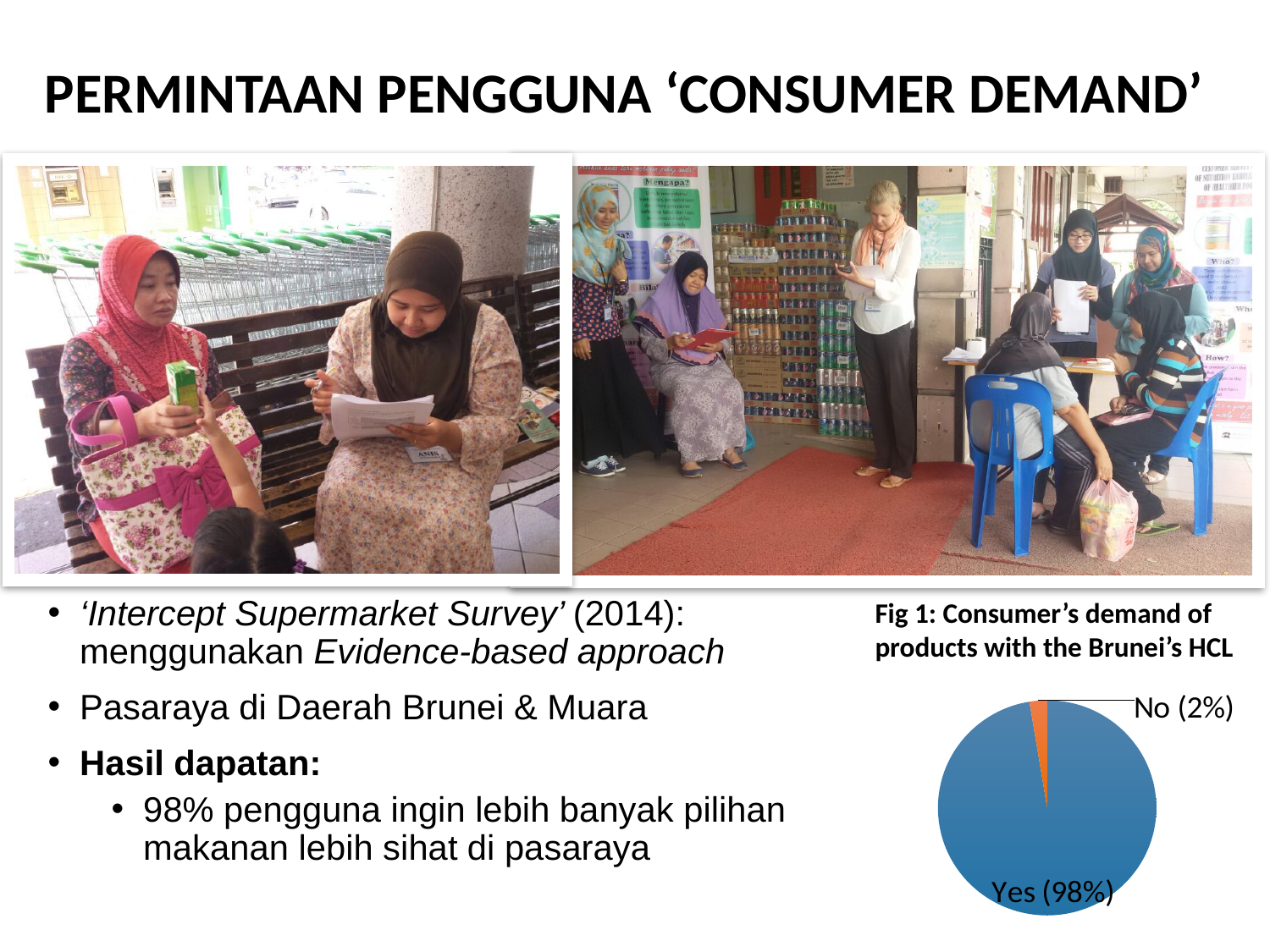
Which slice of the pie chart is the largest? Yes What kind of chart is shown on the slide? pie chart Which is larger in the pie chart, the 'Yes' slice or the 'No' slice? Yes What share of the pie chart is labelled 'Yes'? 98% What share of the pie chart is labelled 'No'? 2% What is the title of the pie chart? Fig 1: Consumer's demand of products with the Brunei's HCL How many slices does the pie chart have? 2 What colour is the 'Yes' slice of the pie chart? blue Which slice of the pie chart is the smallest? No What is the difference in percentage points between the 'Yes' and 'No' slices? 96